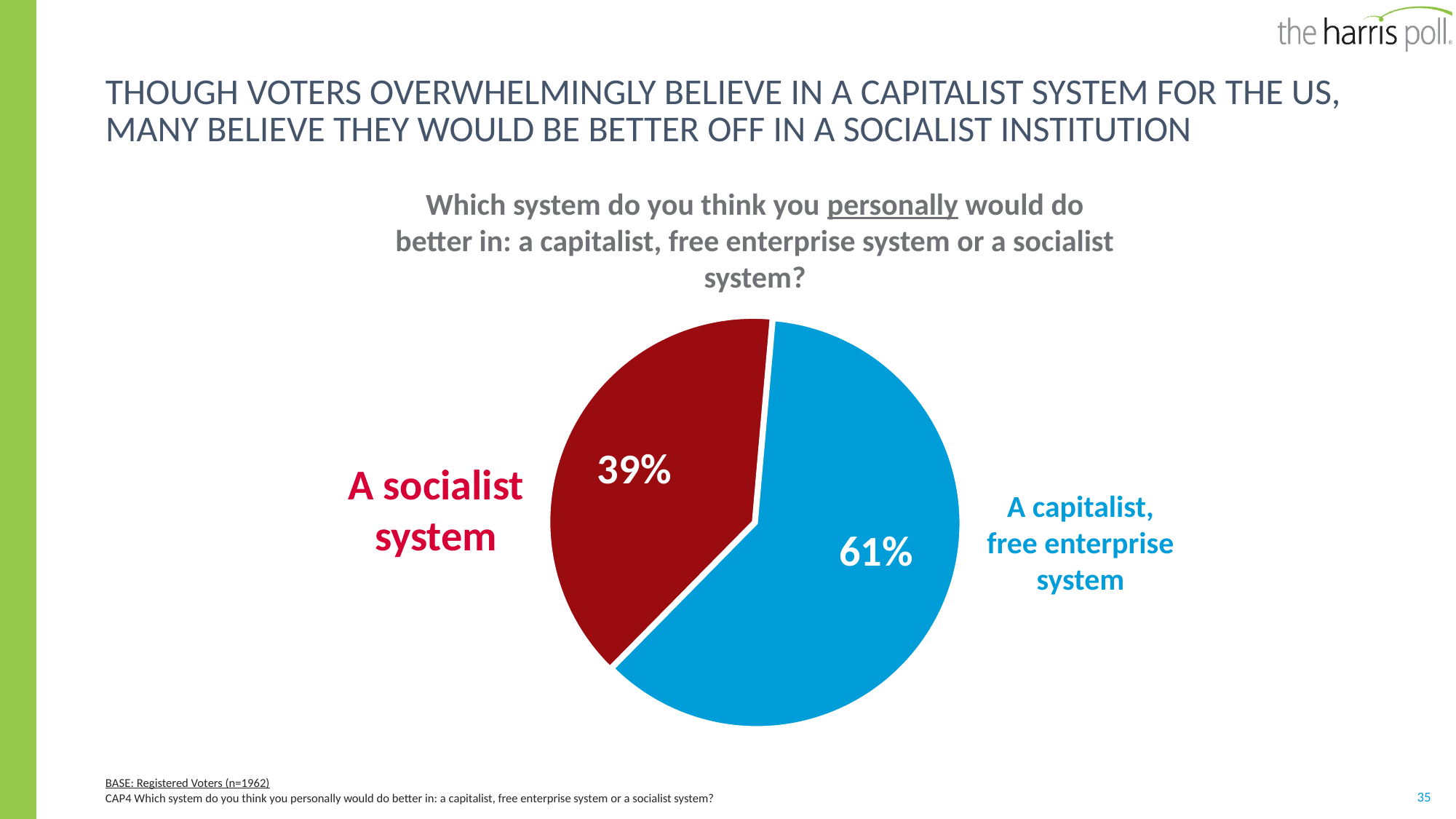
What is the difference in percentage points between the capitalist, free enterprise system slice and the socialist system slice? 22 What kind of chart is shown on the slide? Pie chart What share of the pie does the socialist system slice represent? 39% What percentage of respondents said they would do better in a socialist system? 39% What colour is the slice for a socialist system? Dark red How many slices does the pie chart have? 2 What is the sample size (n) of registered voters stated in the base note? 1962 Which slice of the pie is the largest? A capitalist, free enterprise system What colour is the slice for a capitalist, free enterprise system? Blue Which is larger: the share for a socialist system or the share for a capitalist, free enterprise system? A capitalist, free enterprise system Which slice of the pie is the smallest? A socialist system What percentage of respondents said they would do better in a capitalist, free enterprise system? 61%